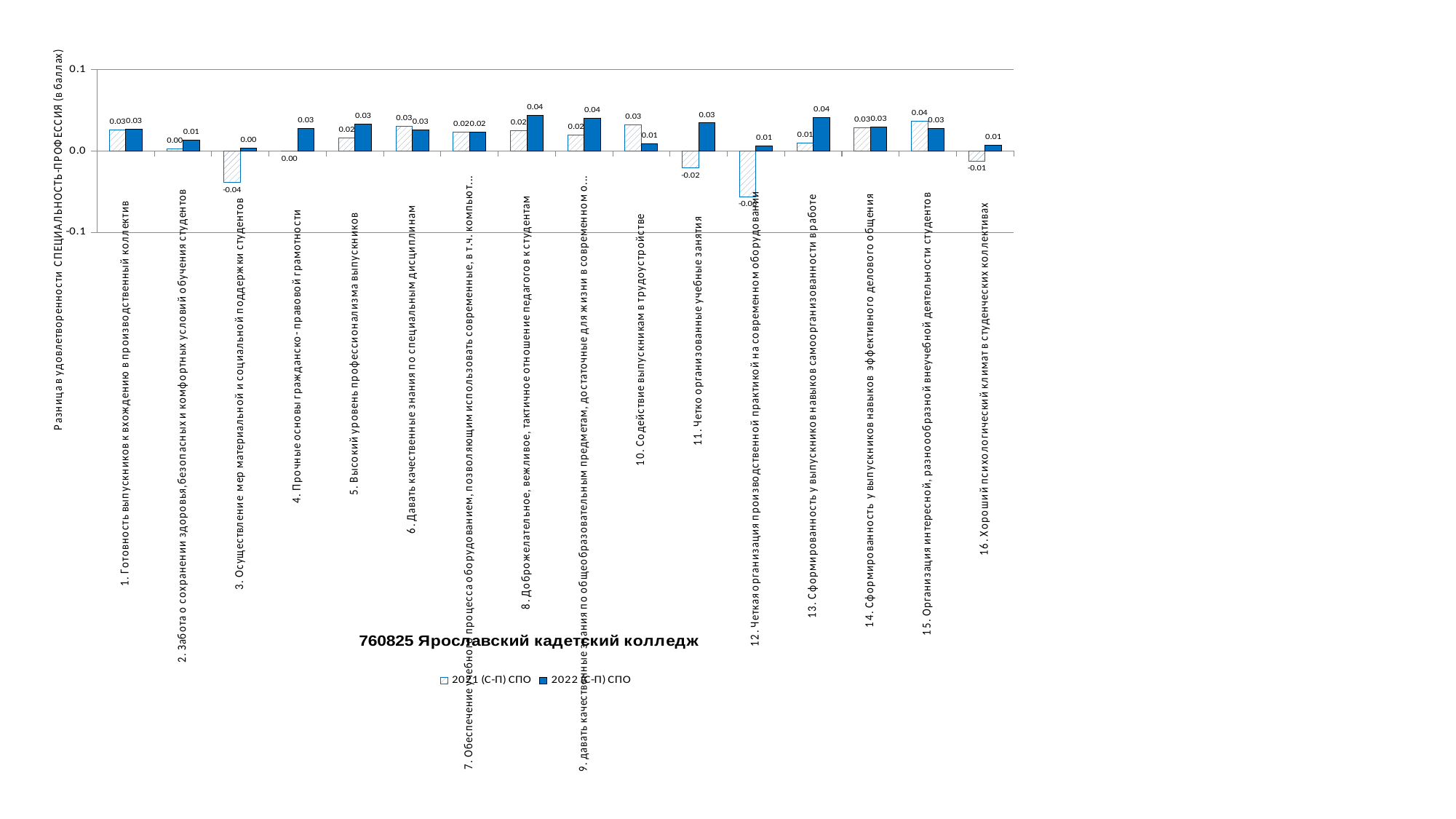
How many series does the legend list? 2 For category 10, Содействие выпускникам в трудоустройстве, which series has the larger value, 2021 (С-П) СПО or 2022 (С-П) СПО? 2021 (С-П) СПО Which category has the highest 2021 (С-П) СПО value? 15. Организация интересной, разнообразной внеучебной деятельности студентов What is the 2021 (С-П) СПО value for category 11, Четко организованные учебные занятия? -0.02 What is the 2021 (С-П) СПО value for category 3, Осуществление мер материальной и социальной поддержки студентов? -0.04 What is the 2022 (С-П) СПО value for category 8, Доброжелательное, вежливое, тактичное отношение педагогов к студентам? 0.04 What type of chart is shown on the slide? bar chart Which category has the lowest 2021 (С-П) СПО value? 12. Четкая организация производственной практикой на современном оборудовании What is the title of the chart? 760825 Ярославский кадетский колледж What is the difference between the 2022 and 2021 values for category 13, Сформированность у выпускников навыков самоорганизованности в работе? 0.03 What is the 2022 (С-П) СПО value for category 4, Прочные основы гражданско-правовой грамотности? 0.03 How many categories are shown on the x axis? 16